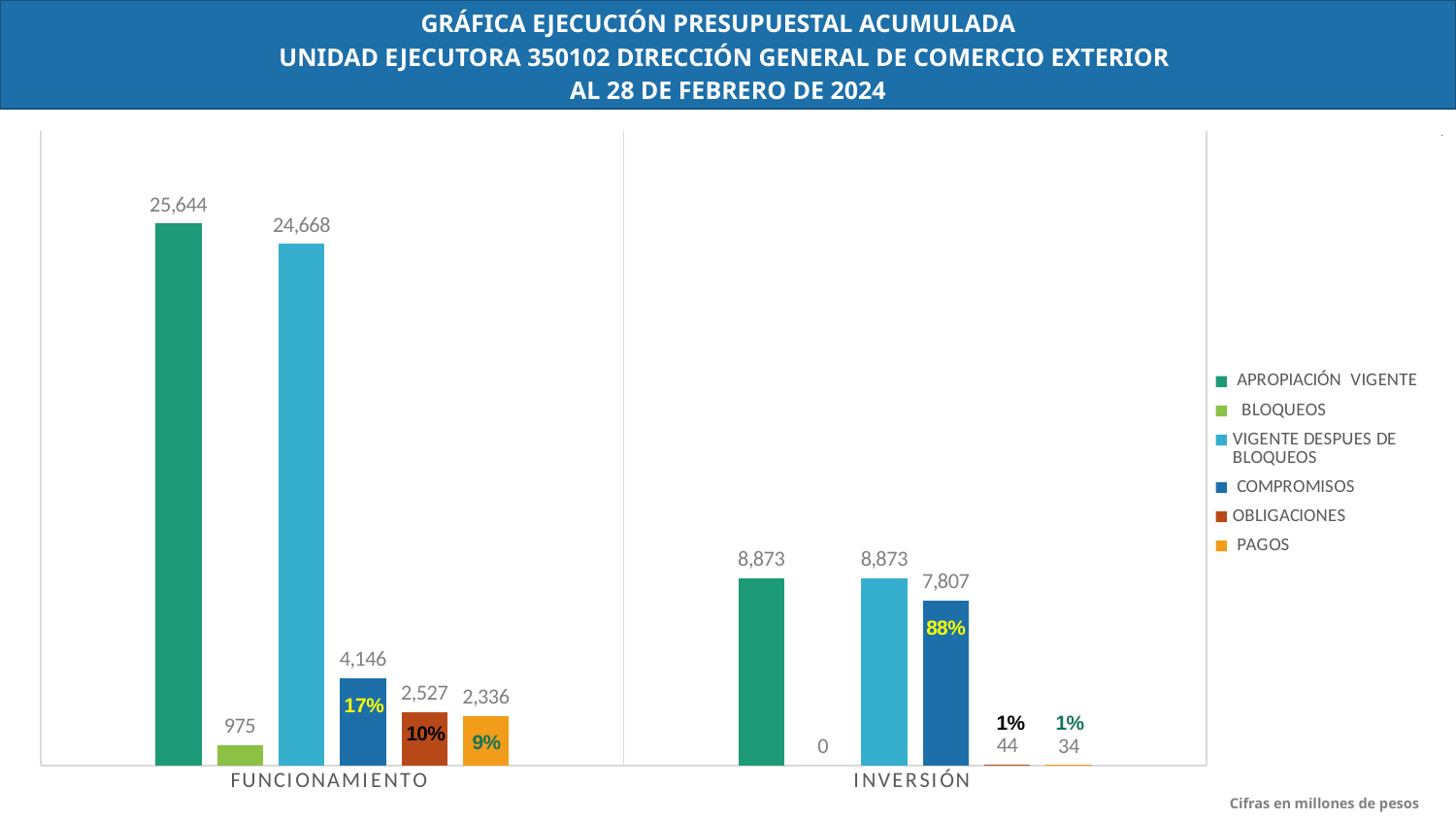
What is the APROPIACIÓN VIGENTE value for FUNCIONAMIENTO? 25,644 What kind of chart is shown on the slide? Bar chart What is the difference between APROPIACIÓN VIGENTE and VIGENTE DESPUES DE BLOQUEOS for FUNCIONAMIENTO? 976 What is the PAGOS value for INVERSIÓN? 34 What is the COMPROMISOS value for INVERSIÓN? 7,807 What is the BLOQUEOS value for INVERSIÓN? 0 How many series does the legend list? 6 What is the BLOQUEOS value for FUNCIONAMIENTO? 975 Which series has the highest value for FUNCIONAMIENTO? APROPIACIÓN VIGENTE Which series has the lowest value for INVERSIÓN? BLOQUEOS What percentage is shown on the COMPROMISOS bar for INVERSIÓN? 88% Which is larger: OBLIGACIONES for FUNCIONAMIENTO or COMPROMISOS for INVERSIÓN? COMPROMISOS for INVERSIÓN